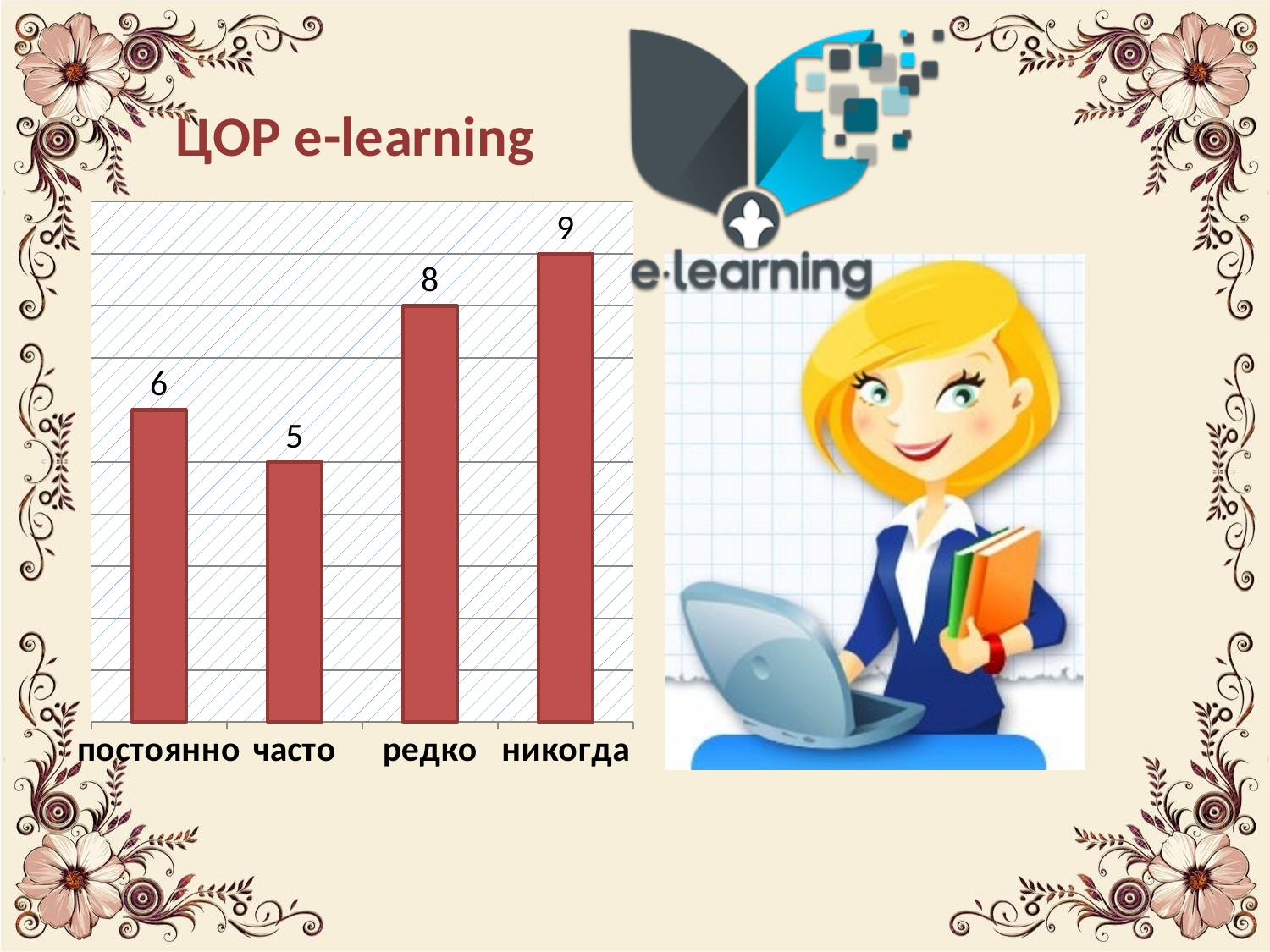
What is the difference between the values for редко and постоянно? 2 What is the title shown above the chart? ЦОР e-learning What is the difference between the values for никогда and часто? 4 How many categories are shown on the chart? 4 What is the value for никогда? 9 What is the value for редко? 8 What is the value for часто? 5 Which category has the highest value? никогда Which category has the lowest value? часто What is the value for постоянно? 6 Which is larger, the value for постоянно or the value for часто? постоянно What kind of chart is shown on the slide? bar chart